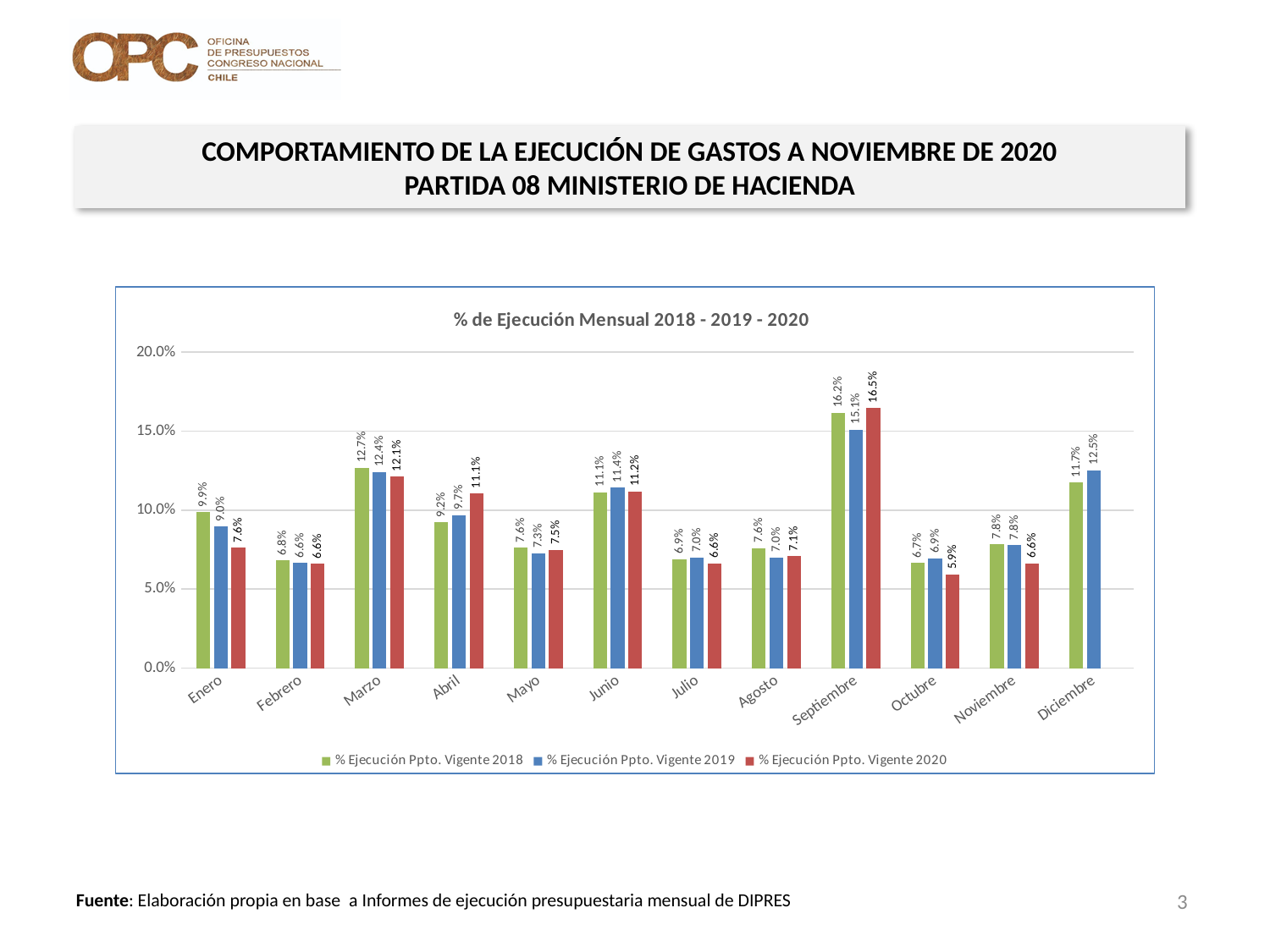
Which month has the lowest value in the % Ejecución Ppto. Vigente 2020 series? Octubre What is the value for Diciembre in the % Ejecución Ppto. Vigente 2019 series? 12.5% What is the difference between the 2018 and 2020 values for Enero? 2.3% How many months are shown on the x axis of the chart? 12 What is the value for Septiembre in the % Ejecución Ppto. Vigente 2020 series? 16.5% For Abril, which series has the larger value: % Ejecución Ppto. Vigente 2018 or % Ejecución Ppto. Vigente 2020? % Ejecución Ppto. Vigente 2020 Is the value for Septiembre in the 2019 series greater or less than 15.0%? greater How many series does the legend list? 3 What kind of chart is shown on the slide? Bar chart Which month has the highest value in the % Ejecución Ppto. Vigente 2018 series? Septiembre What is the title of the chart? % de Ejecución Mensual 2018 - 2019 - 2020 What is the value for Marzo in the % Ejecución Ppto. Vigente 2018 series? 12.7%